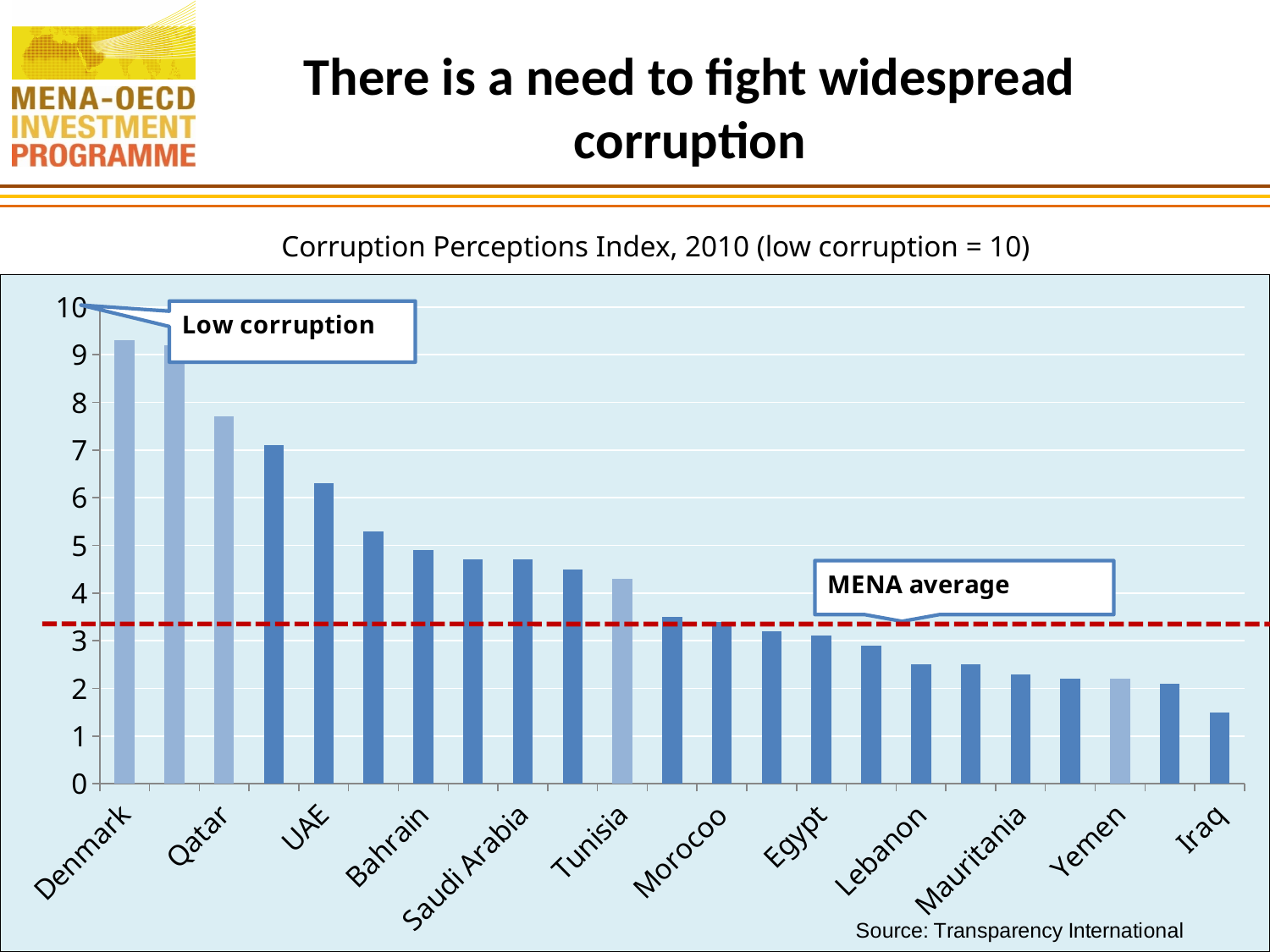
Is the value for Denmark greater or less than 9? greater Which has a higher Corruption Perceptions Index value, Bahrain or Egypt? Bahrain What kind of chart is shown on the slide? bar chart Do the bar values rise or fall from left to right along the x axis? fall What does the red dashed horizontal line on the chart represent? MENA average Which country has the highest Corruption Perceptions Index value? Denmark Is the value for Qatar greater or less than 7? greater Which country has the lowest Corruption Perceptions Index value? Iraq Is the value for UAE greater or less than 6? greater Which has a higher Corruption Perceptions Index value, Qatar or UAE? Qatar